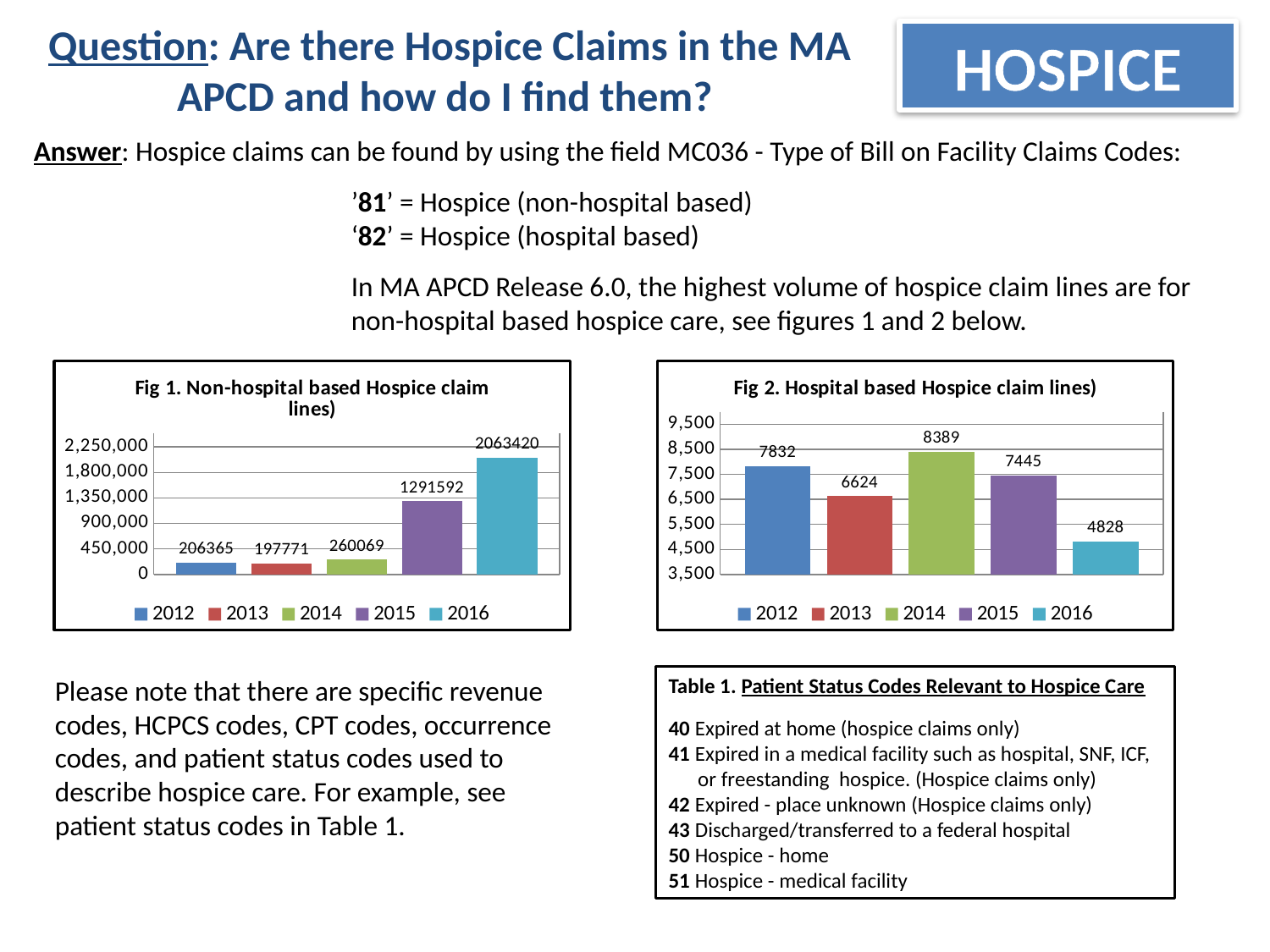
In Fig 1 (Non-hospital based Hospice claim lines), what is the value for 2013? 197771 In Fig 2 (Hospital based Hospice claim lines), what is the difference between the 2012 and 2013 values? 1208 In Fig 2 (Hospital based Hospice claim lines), which year has the lowest value? 2016 In Fig 1 (Non-hospital based Hospice claim lines), what is the value for 2016? 2063420 In Fig 2 (Hospital based Hospice claim lines), which year has the highest value? 2014 In Fig 1 (Non-hospital based Hospice claim lines), is the value for 2015 greater or less than 900,000? greater In Fig 1 (Non-hospital based Hospice claim lines), how many years are plotted? 5 In Fig 2 (Hospital based Hospice claim lines), what is the value for 2014? 8389 In Fig 1 (Non-hospital based Hospice claim lines), what is the difference between the 2016 and 2015 values? 771828 In Fig 2 (Hospital based Hospice claim lines), which is larger, the value for 2012 or the value for 2015? 2012 In Fig 1 (Non-hospital based Hospice claim lines), which year has the lowest value? 2013 What type of chart is Fig 2 (Hospital based Hospice claim lines)? bar chart